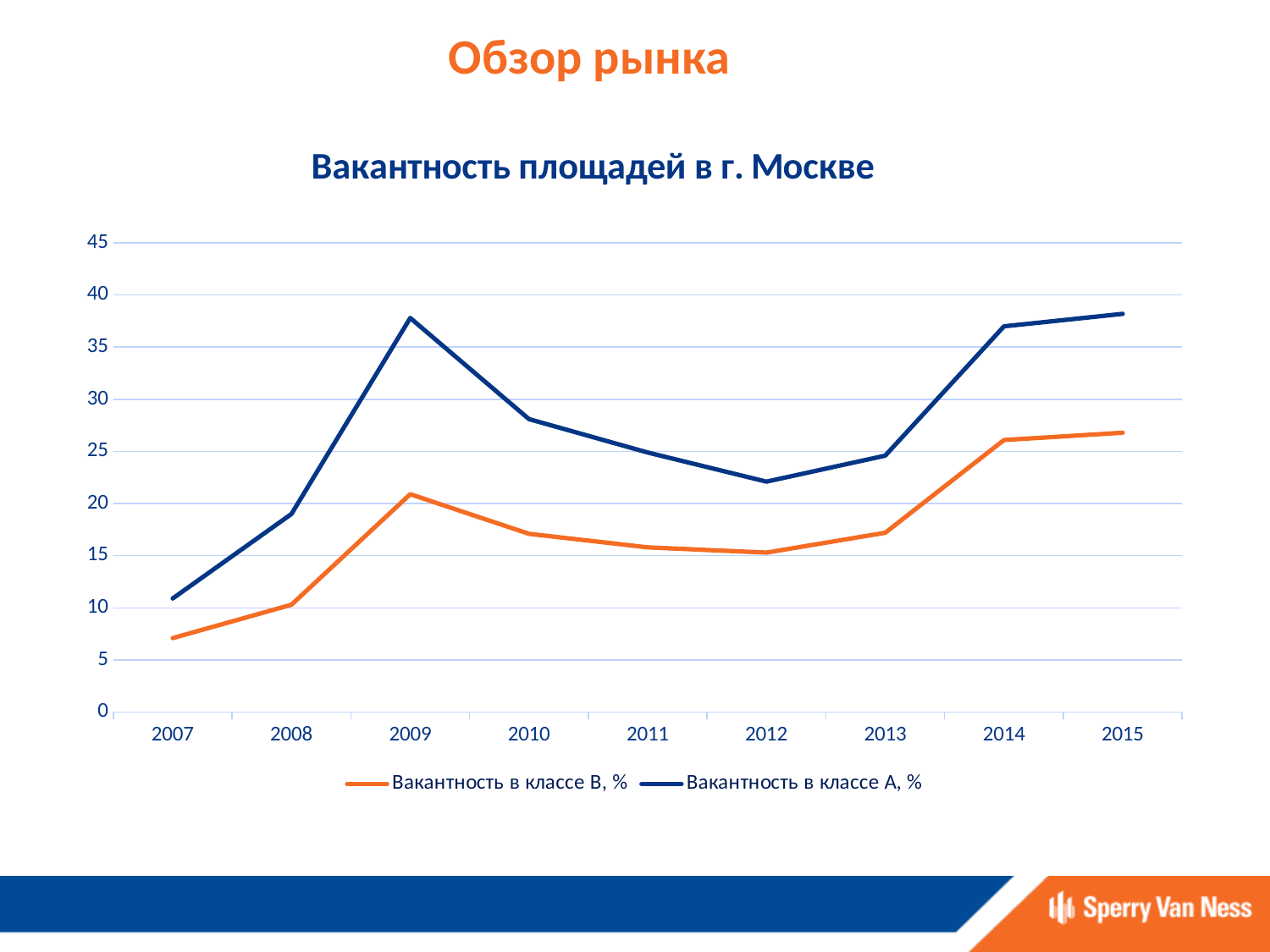
Is the value for Вакантность в классе В, % in 2012 greater or less than 20? less What kind of chart is shown on the slide? line chart How many years are plotted along the x axis? 9 Is the value for Вакантность в классе В, % in 2007 greater or less than 10? less Between 2009 and 2012, does the value for Вакантность в классе А, % rise or fall? fall How many series does the legend list? 2 Is the value for Вакантность в классе А, % in 2009 greater or less than 35? greater In which year is the value for Вакантность в классе А, % lowest? 2007 In 2010, which series has the larger value: Вакантность в классе А, % or Вакантность в классе В, %? Вакантность в классе А, % In which year is the value for Вакантность в классе В, % lowest? 2007 What is the title of the chart? Вакантность площадей в г. Москве